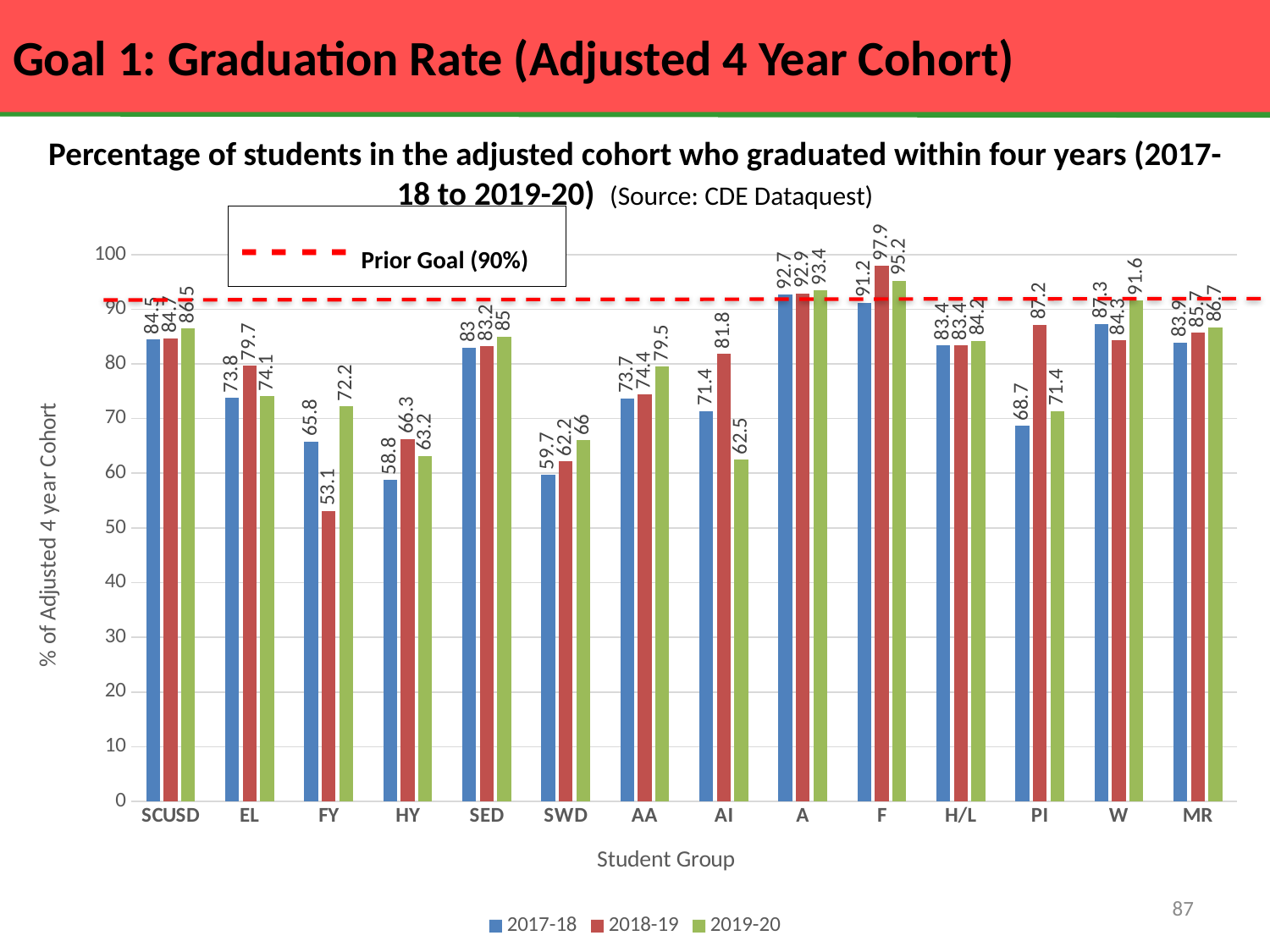
How much higher is the 2018-19 value than the 2017-18 value for the PI student group? 18.5 For the AI student group, which year has the larger value: 2018-19 or 2019-20? 2018-19 What value does the red dashed 'Prior Goal' line represent? 90% What kind of chart is shown on the slide? Bar chart What is the 2018-19 graduation rate for the FY student group? 53.1 What is the 2018-19 value for the F student group? 97.9 Which student group has the highest 2019-20 value? F Which student group has the lowest 2018-19 value? FY How many student groups are shown on the x axis? 14 For the SWD student group, do the values rise or fall from 2017-18 to 2019-20? Rise How many series does the legend list? 3 What is the 2019-20 value for the W student group? 91.6